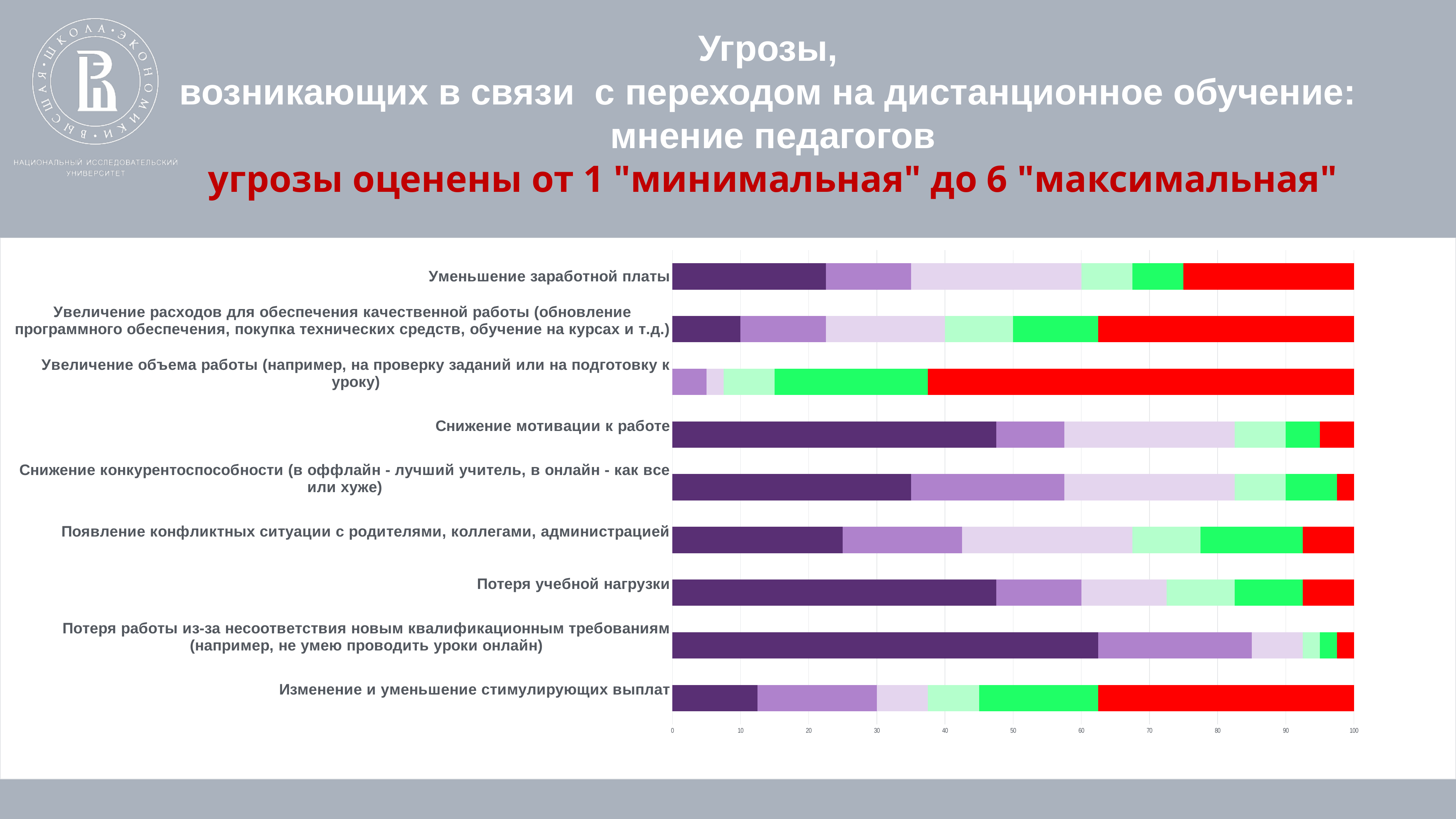
How many coloured segments make up each stacked bar? 6 Is the dark purple segment for "Уменьшение заработной платы" greater or less than 30? less What is the maximum value shown on the horizontal axis? 100 Which category has the smallest dark purple (minimum threat) segment? Увеличение объема работы (например, на проверку заданий или на подготовку к уроку) How many threat categories are plotted on the chart? 9 Which has the larger red segment: "Уменьшение заработной платы" or "Снижение мотивации к работе"? Уменьшение заработной платы Which category has the largest dark purple (minimum threat) segment? Потеря работы из-за несоответствия новым квалификационным требованиям (например, не умею проводить уроки онлайн) Is the dark purple segment for "Снижение мотивации к работе" greater or less than 40? greater Which category has the largest red (maximum threat) segment? Увеличение объема работы (например, на проверку заданий или на подготовку к уроку) What kind of chart is shown on the slide? Stacked bar chart Is the dark purple segment for "Потеря работы из-за несоответствия новым квалификационным требованиям" greater or less than 50? greater